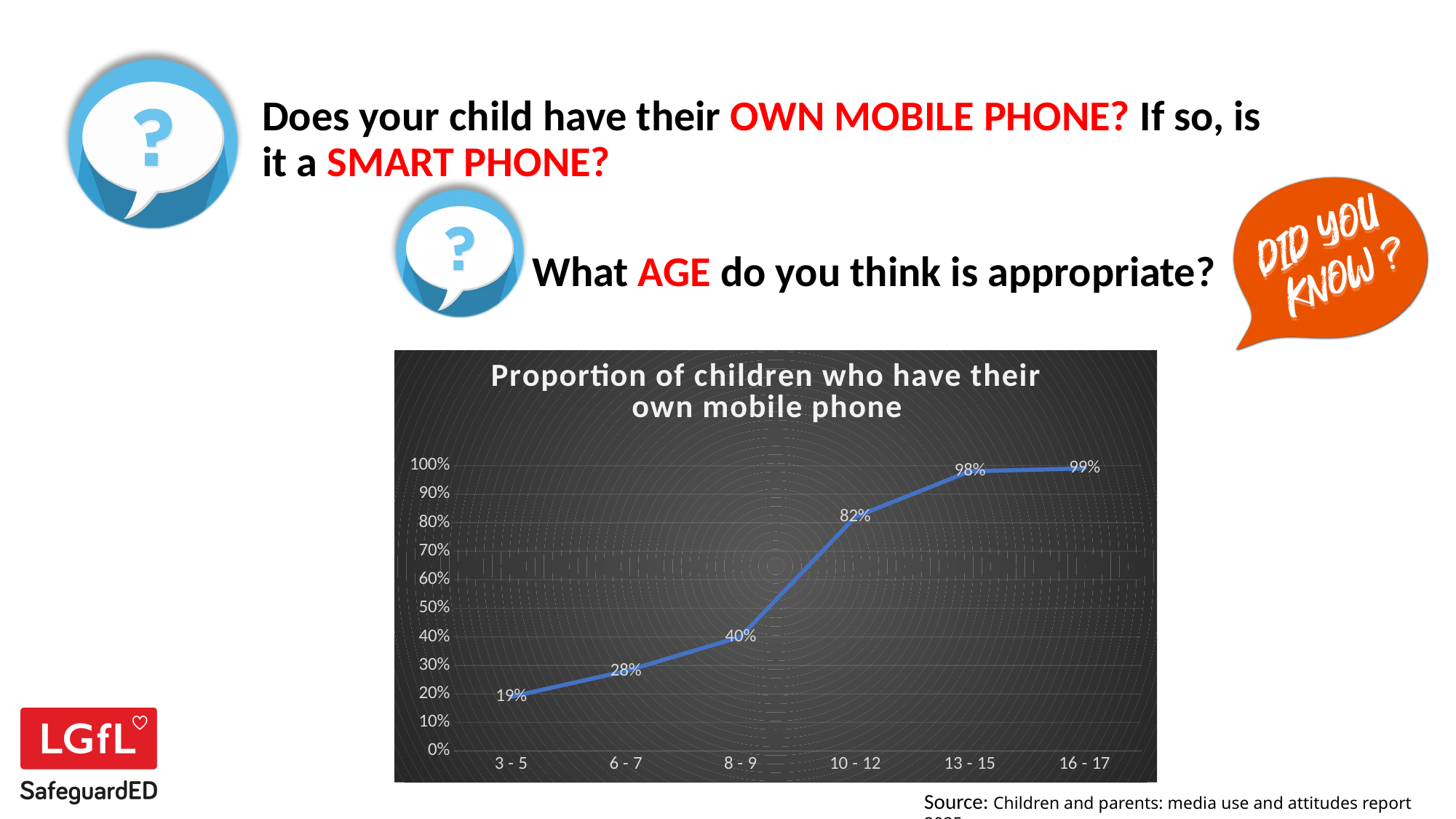
What proportion of children aged 3 - 5 have their own mobile phone? 19% How many age groups are plotted on the chart? 6 What proportion of children aged 10 - 12 have their own mobile phone? 82% Which is larger, the proportion for ages 6 - 7 or ages 8 - 9? 8 - 9 Which age group has the lowest proportion of children with their own mobile phone? 3 - 5 What is the title of the chart? Proportion of children who have their own mobile phone Do the values rise or fall as age increases along the x axis? rise What proportion of children aged 8 - 9 have their own mobile phone? 40% What is the difference between the proportion for ages 10 - 12 and ages 8 - 9? 42% What is the difference between the proportion for ages 16 - 17 and ages 3 - 5? 80% What type of chart is shown on the slide? line chart Which age group has the highest proportion of children with their own mobile phone? 16 - 17